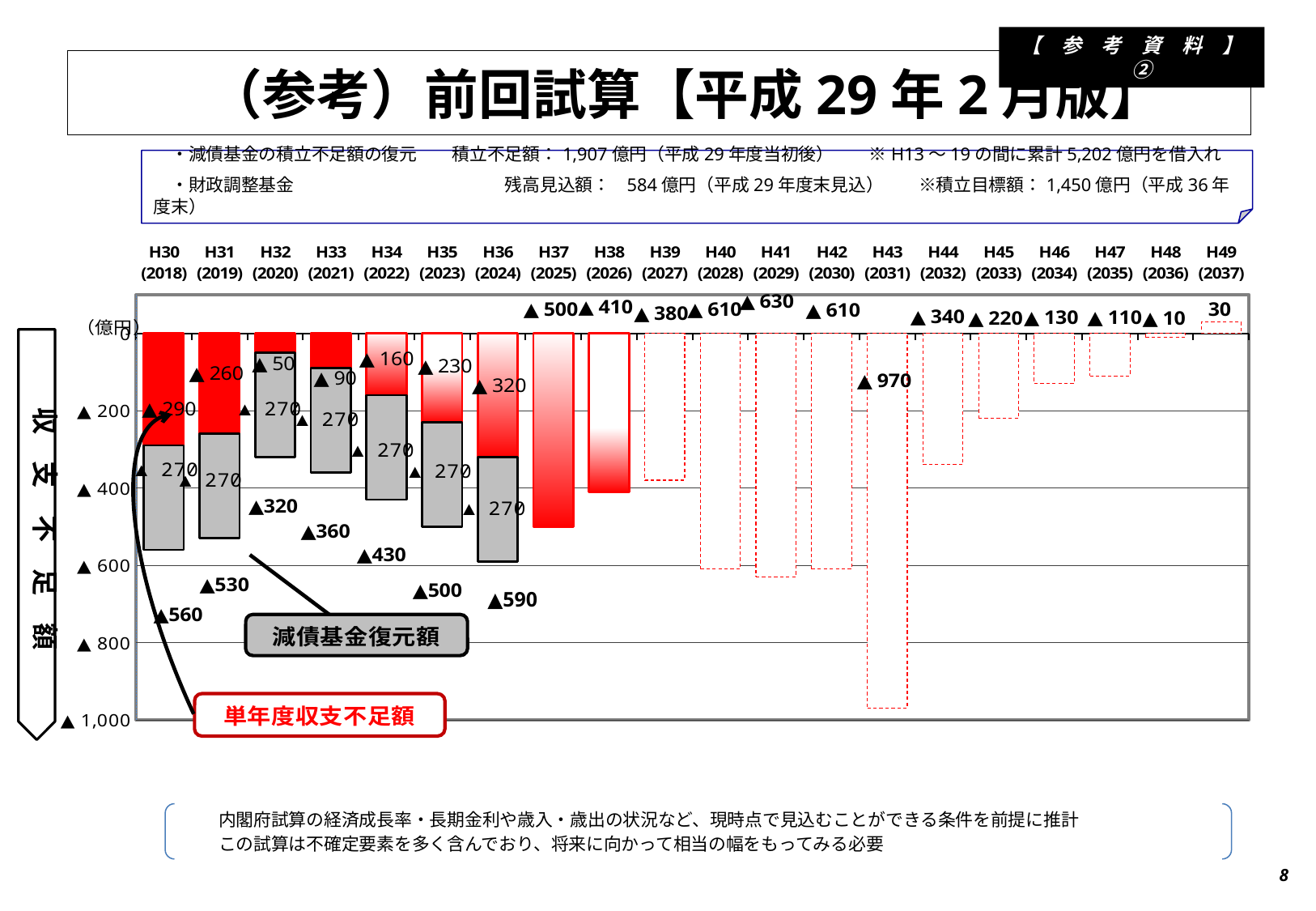
Which has the larger labelled value, H37 (2025) or H38 (2026)? H37 (2025) What is the difference between the labelled values for H41 (2029) and H40 (2028)? 20 What is the labelled value of the red (単年度収支不足額) bar for H32 (2020)? ▲50 What is the 減債基金復元額 (grey bar) value for H30 (2018)? 270 Which fiscal year has the largest labelled deficit value in the chart? H43 (2031) What is the labelled value for H43 (2031) in the chart? ▲970 What unit is shown at the top of the vertical axis of the chart? 億円 What is the total labelled below the stacked bar for H30 (2018)? ▲560 How many fiscal years (categories) are shown along the x axis of the chart? 20 What kind of chart is shown on the slide? bar chart What is the total labelled below the stacked bar for H36 (2024)? ▲590 What is the labelled value for H49 (2037)? 30